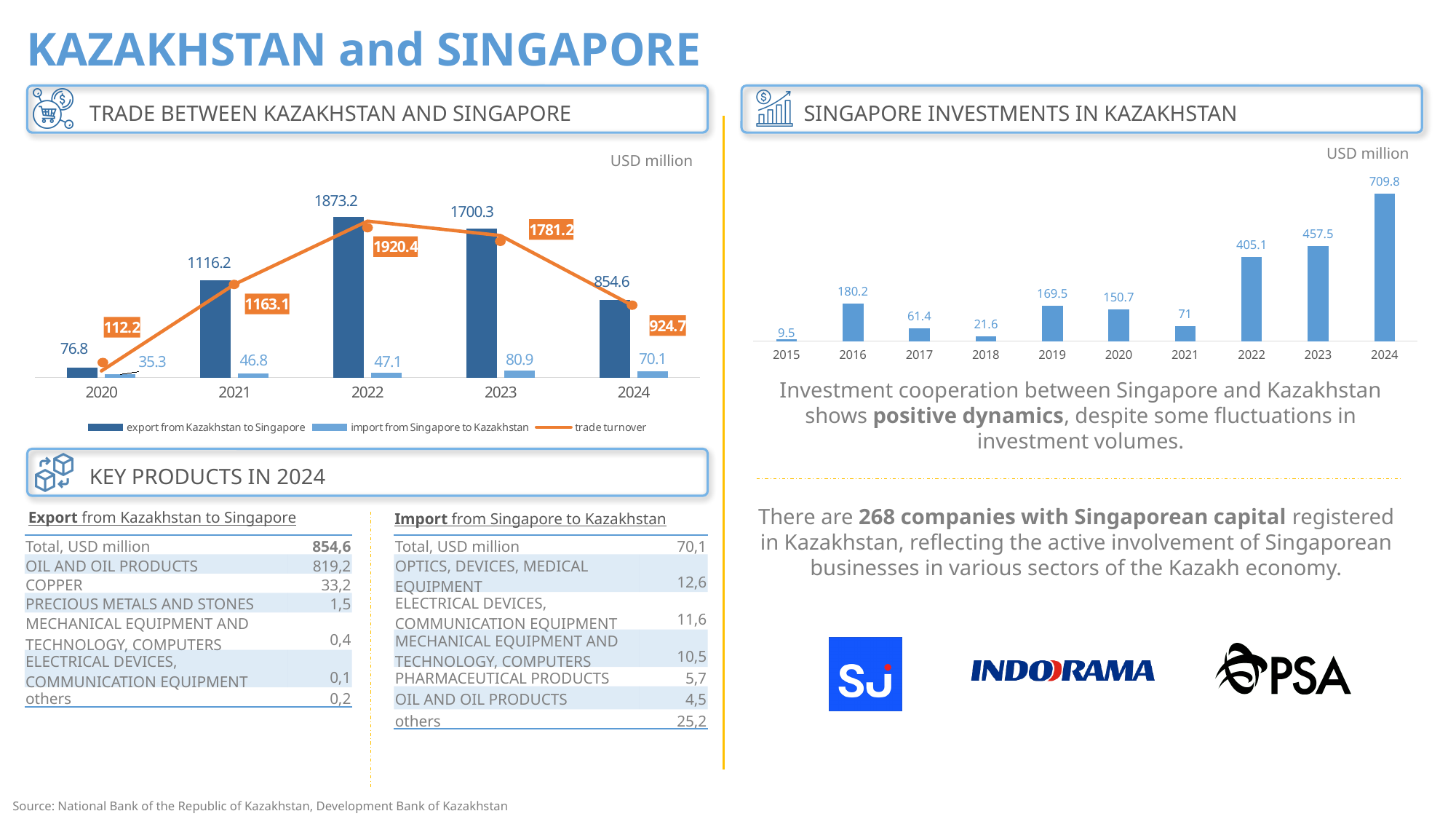
In the 'Trade between Kazakhstan and Singapore' chart, what was the export from Kazakhstan to Singapore in 2022? 1873.2 In the 'Trade between Kazakhstan and Singapore' chart, what was the import from Singapore to Kazakhstan in 2023? 80.9 In the 'Singapore investments in Kazakhstan' chart, which year had the lowest value? 2015 In the 'Trade between Kazakhstan and Singapore' chart, what is the difference between export and import in 2024? 784.5 What kind of chart is the 'Singapore investments in Kazakhstan' chart? bar chart In the 'Singapore investments in Kazakhstan' chart, how many years are shown? 10 In the 'Trade between Kazakhstan and Singapore' chart, what was the trade turnover in 2021? 1163.1 In the 'Singapore investments in Kazakhstan' chart, what was the value for 2019? 169.5 In the 'Trade between Kazakhstan and Singapore' chart, how many series does the legend list? 3 In the 'Singapore investments in Kazakhstan' chart, what is the difference between the 2024 and 2023 values? 252.3 In the 'Trade between Kazakhstan and Singapore' chart, did the export from Kazakhstan to Singapore rise or fall from 2022 to 2024? fall In the 'Trade between Kazakhstan and Singapore' chart, which year had the highest trade turnover? 2022